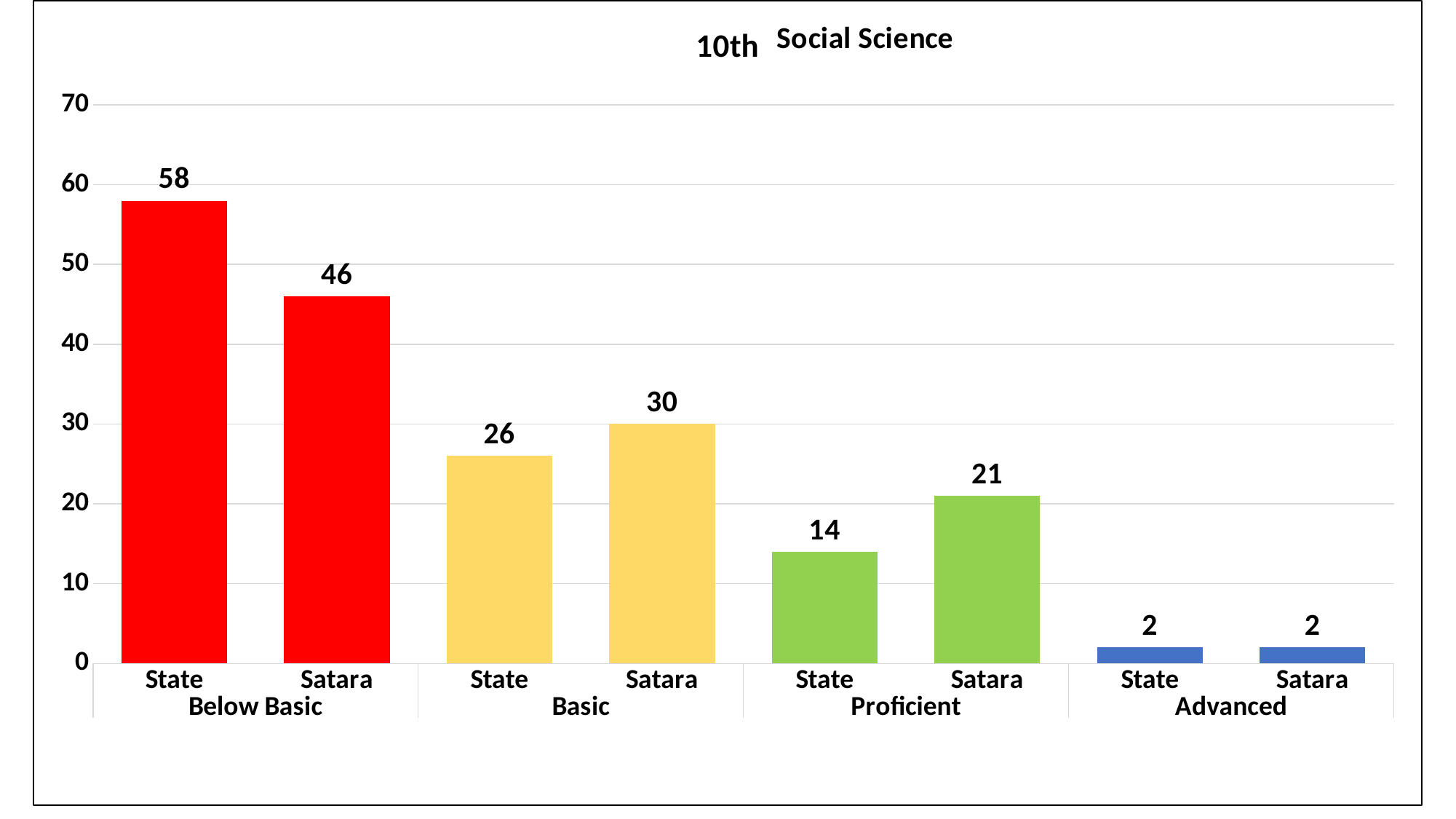
What is the difference between the State and Satara values in the Below Basic group? 12 What is the value for Satara in the Basic group? 30 How many performance level groups are shown on the x axis? 4 What is the value for Satara in the Proficient group? 21 What is the value for State in the Below Basic group? 58 Which is larger in the Proficient group, State or Satara? Satara How many bars are plotted on the chart? 8 Which bar has the highest value on the chart? State, Below Basic What is the difference between the Satara and State values in the Proficient group? 7 What kind of chart is shown on the slide? Bar chart Which is larger in the Basic group, State or Satara? Satara What is the title of the chart? 10th Social Science